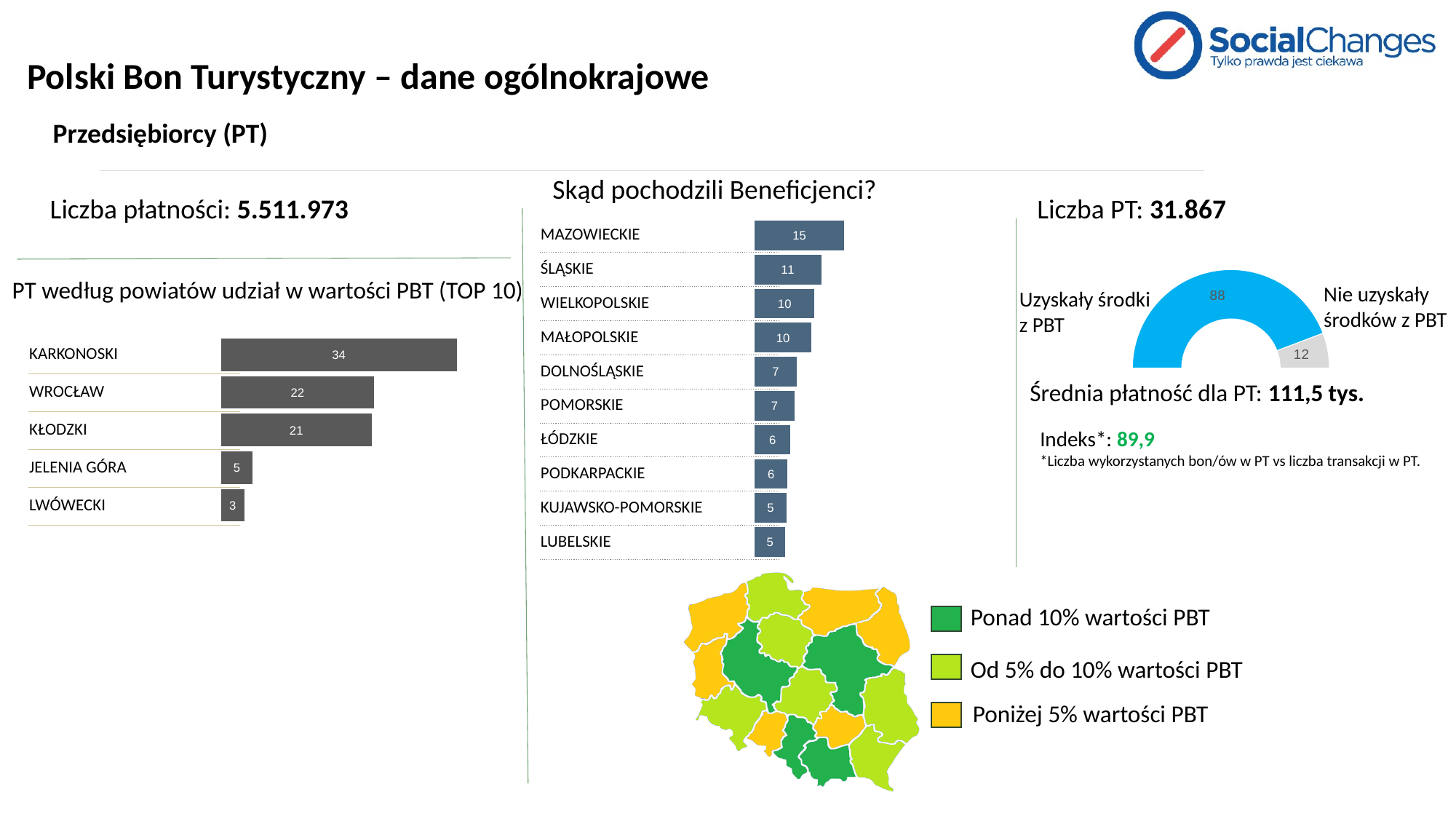
In the chart 'Skąd pochodzili Beneficjenci?', what is the difference between the values for MAZOWIECKIE and LUBELSKIE? 10 In the chart 'Skąd pochodzili Beneficjenci?', which category has the highest value? MAZOWIECKIE How many categories are shown in the chart 'PT według powiatów udział w wartości PBT (TOP 10)'? 5 In the doughnut chart on the right of the slide, what is the value for 'Nie uzyskały środków z PBT'? 12 In the doughnut chart on the right of the slide, what is the value for 'Uzyskały środki z PBT'? 88 In the chart 'Skąd pochodzili Beneficjenci?', which is larger, the value for ŚLĄSKIE or the value for DOLNOŚLĄSKIE? ŚLĄSKIE In the chart 'PT według powiatów udział w wartości PBT (TOP 10)', what is the value for KARKONOSKI? 34 In the chart 'Skąd pochodzili Beneficjenci?', what is the value for MAZOWIECKIE? 15 In the chart 'PT według powiatów udział w wartości PBT (TOP 10)', which category has the lowest value? LWÓWECKI In the chart 'PT według powiatów udział w wartości PBT (TOP 10)', what is the difference between the values for WROCŁAW and KŁODZKI? 1 What kind of chart is 'Skąd pochodzili Beneficjenci?'? bar chart How many categories are shown in the chart 'Skąd pochodzili Beneficjenci?'? 10